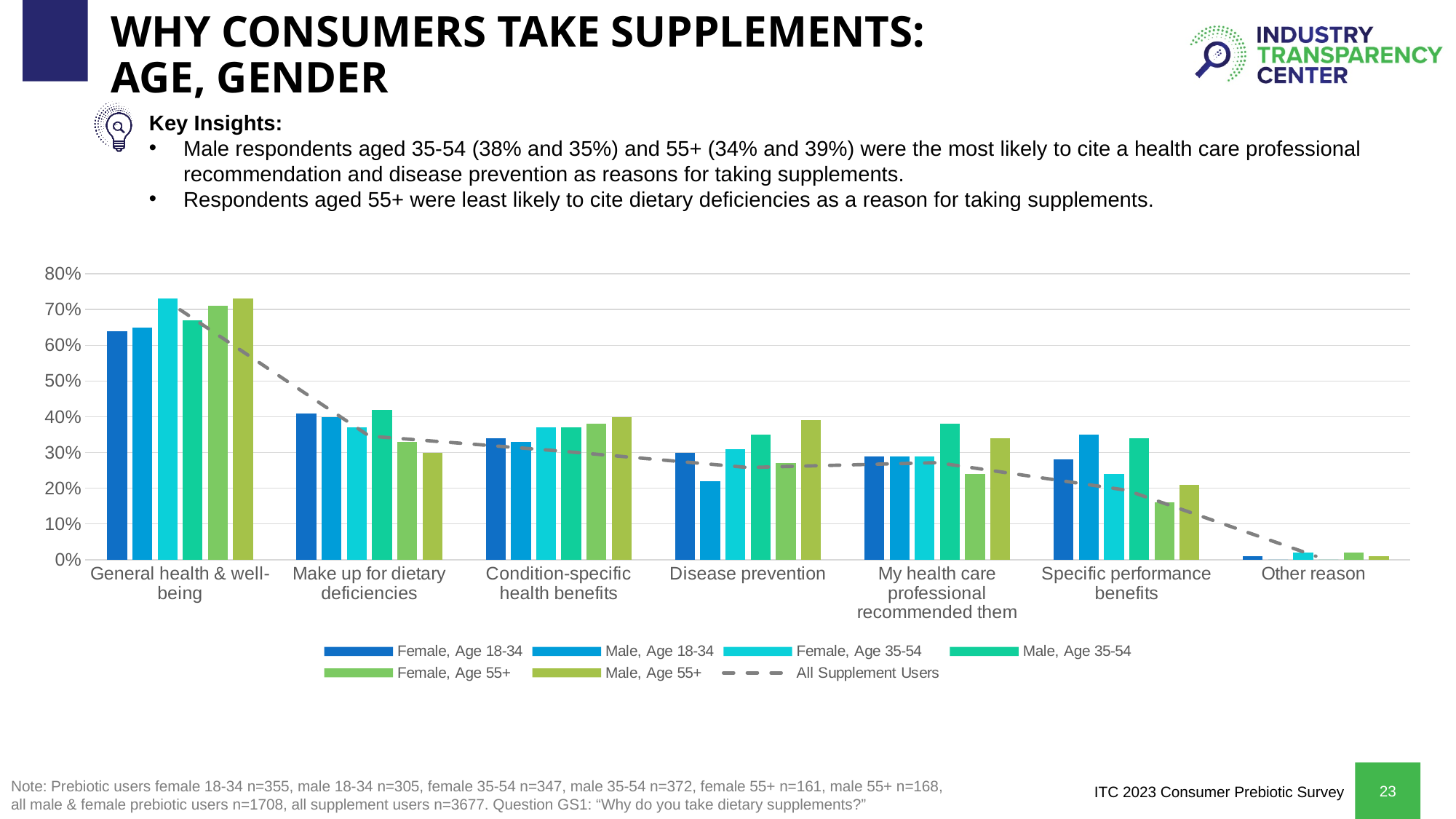
Is the value for Female, Age 55+ in Specific performance benefits greater or less than 20%? less What kind of chart is shown on the slide? combination bar and line chart How many reason categories are shown on the x axis? 7 In General health & well-being, which is larger: Female, Age 35-54 or Female, Age 18-34? Female, Age 35-54 Which category has the lowest bars overall? Other reason In Disease prevention, which is larger: Male, Age 55+ or Male, Age 18-34? Male, Age 55+ Which legend entry is shown as a dashed line rather than bars? All Supplement Users Which category has the highest bars overall? General health & well-being Does the All Supplement Users dashed line rise or fall from left to right across the categories? fall How many entries does the legend list? 7 Is the value for Male, Age 18-34 in Disease prevention greater or less than 30%? less Is the value for Female, Age 18-34 in General health & well-being greater or less than 60%? greater